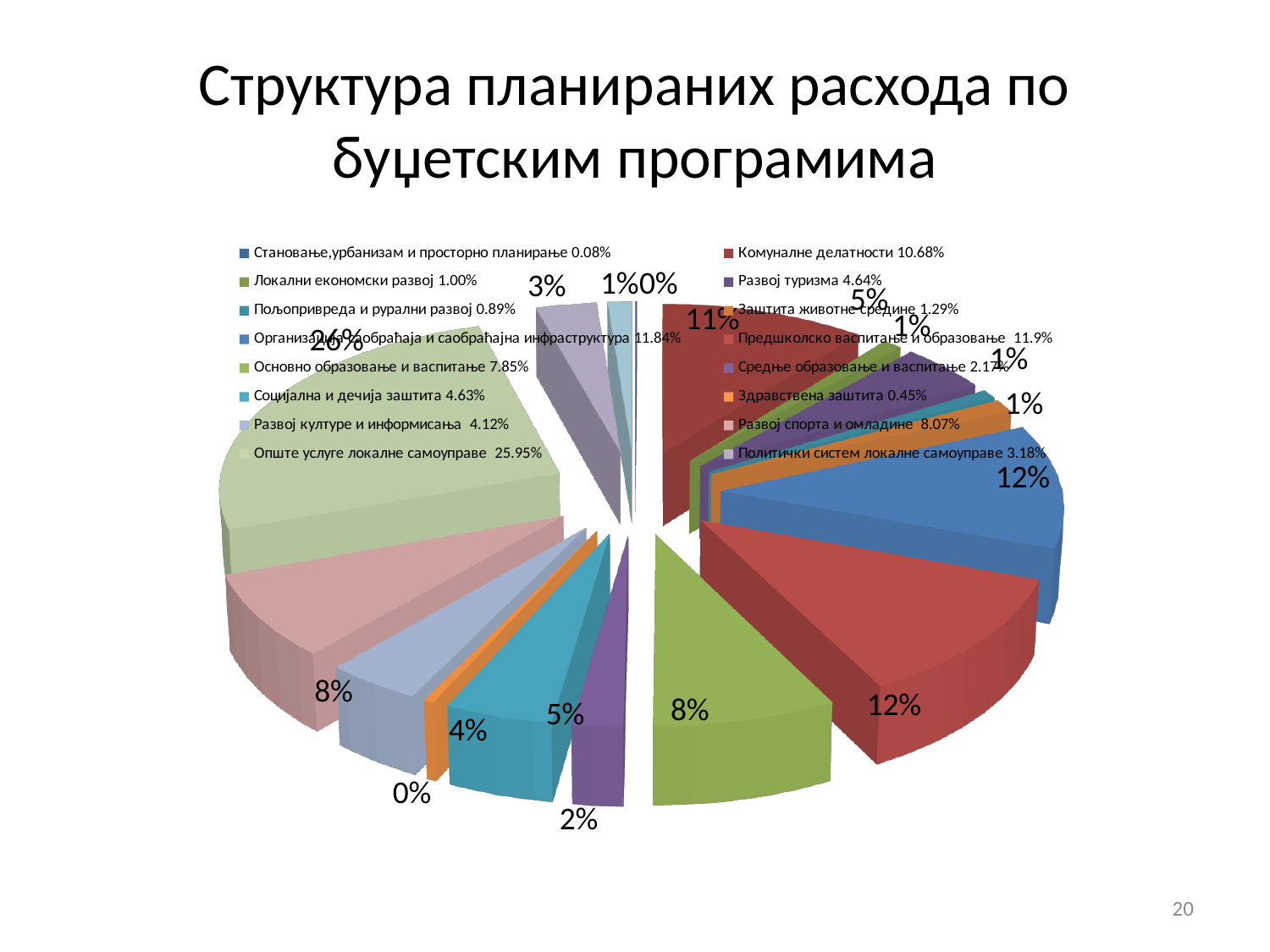
What percentage is shown in the legend for Развој спорта и омладине? 8.07% Which has a larger share: Комуналне делатности or Развој спорта и омладине? Комуналне делатности What share of the pie does Опште услуге локалне самоуправе have, according to the legend? 25.95% What percentage is shown in the legend for Комуналне делатности? 10.68% What percentage is shown in the legend for Предшколско васпитање и образовање? 11.9% What is the title of the chart on the slide? Структура планираних расхода по буџетским програмима How many categories does the pie chart's legend list? 16 What percentage is shown in the legend for Здравствена заштита? 0.45% Which category has the smallest share of the pie? Становање,урбанизам и просторно планирање What kind of chart is shown on the slide? pie chart What is the difference between the shares of Опште услуге локалне самоуправе (25.95%) and Комуналне делатности (10.68%)? 15.27% Which category has the largest share of the pie? Опште услуге локалне самоуправе